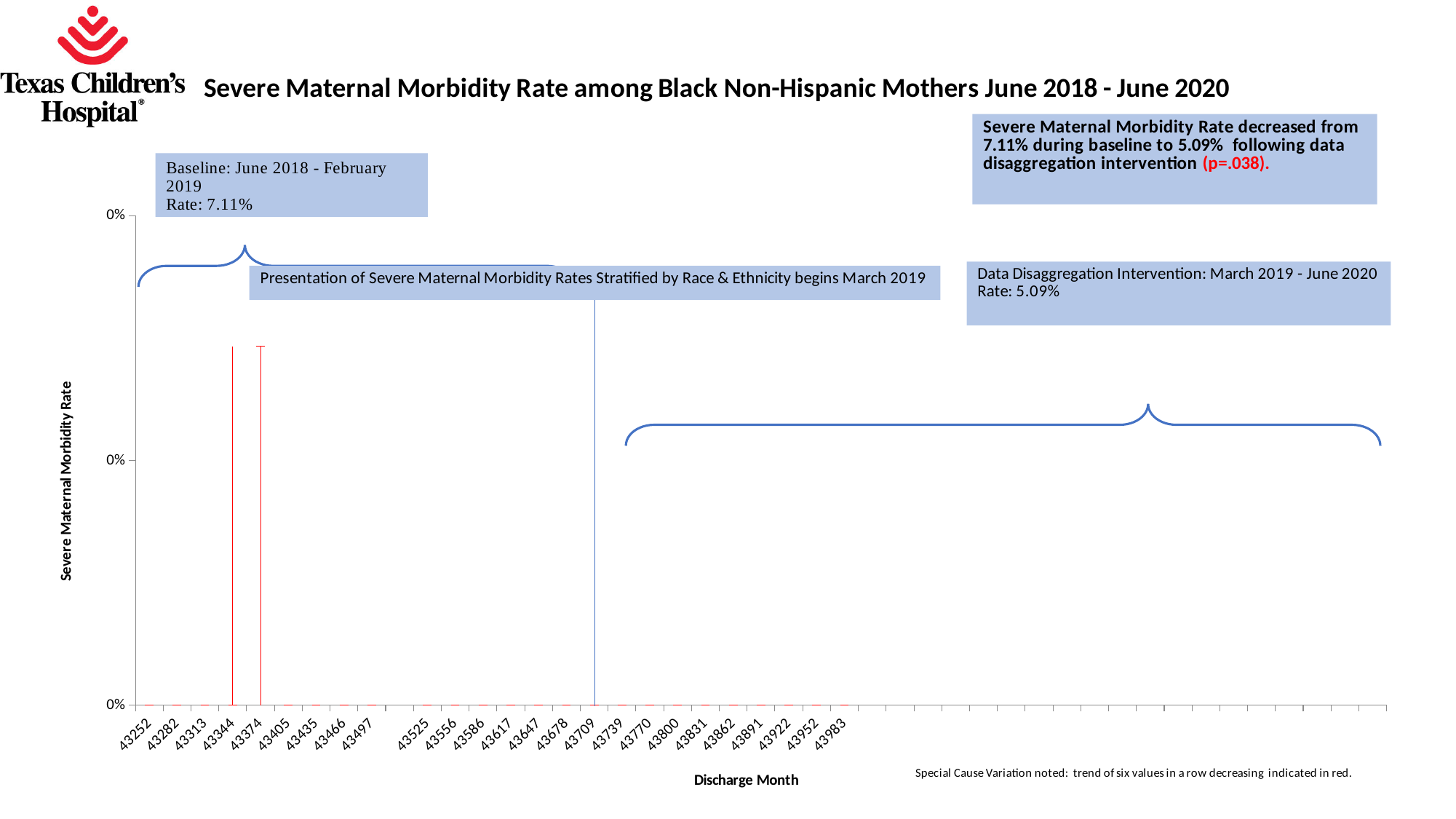
According to the note on the chart, what does red indicate? A trend of six values in a row decreasing What date range does the baseline period cover? June 2018 - February 2019 What date range does the Data Disaggregation Intervention period cover? March 2019 - June 2020 What p-value is reported for the decrease in Severe Maternal Morbidity Rate? .038 By how many percentage points did the Severe Maternal Morbidity Rate decrease from baseline to the intervention period? 2.02% What was the Severe Maternal Morbidity Rate during the baseline period? 7.11% In what month and year does the presentation of Severe Maternal Morbidity Rates stratified by race and ethnicity begin? March 2019 Which period had the higher Severe Maternal Morbidity Rate, the baseline or the Data Disaggregation Intervention period? Baseline What is the title of the chart? Severe Maternal Morbidity Rate among Black Non-Hispanic Mothers June 2018 - June 2020 Did the Severe Maternal Morbidity Rate rise or fall from the baseline period to the intervention period? Fall What was the Severe Maternal Morbidity Rate during the Data Disaggregation Intervention period? 5.09%